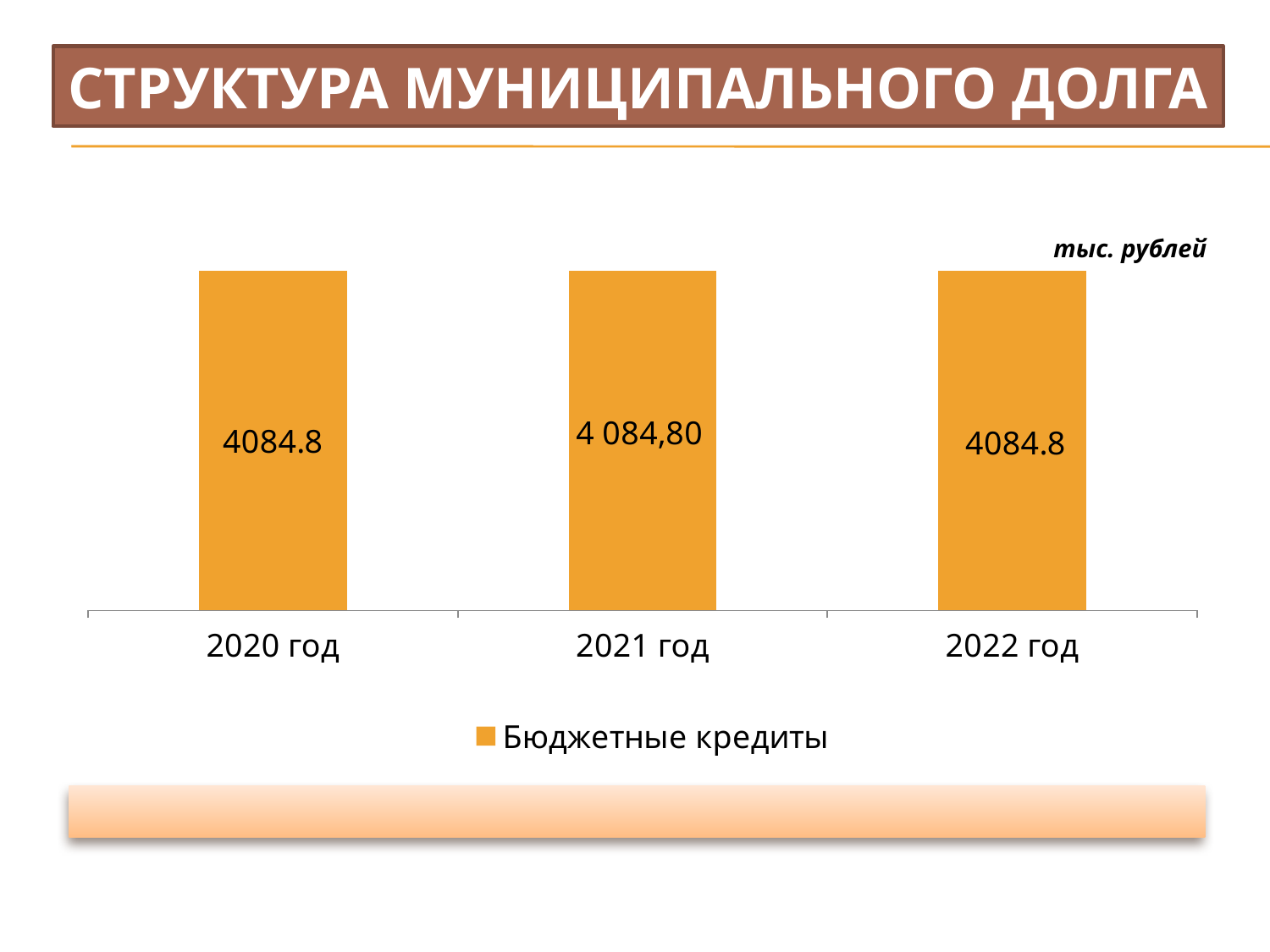
What is the value for 2020 год? 4084.8 What unit is indicated for the chart values? тыс. рублей What is the value shown on the bar for 2021 год? 4 084,80 What is the value for 2022 год? 4084.8 How many categories (years) are shown on the x axis? 3 What series name is listed in the legend? Бюджетные кредиты What kind of chart is shown on the slide? Bar chart Do the values rise, fall or stay the same from 2020 год to 2022 год? Stay the same How many series does the legend list? 1 What is the difference between the values for 2020 год and 2022 год? 0